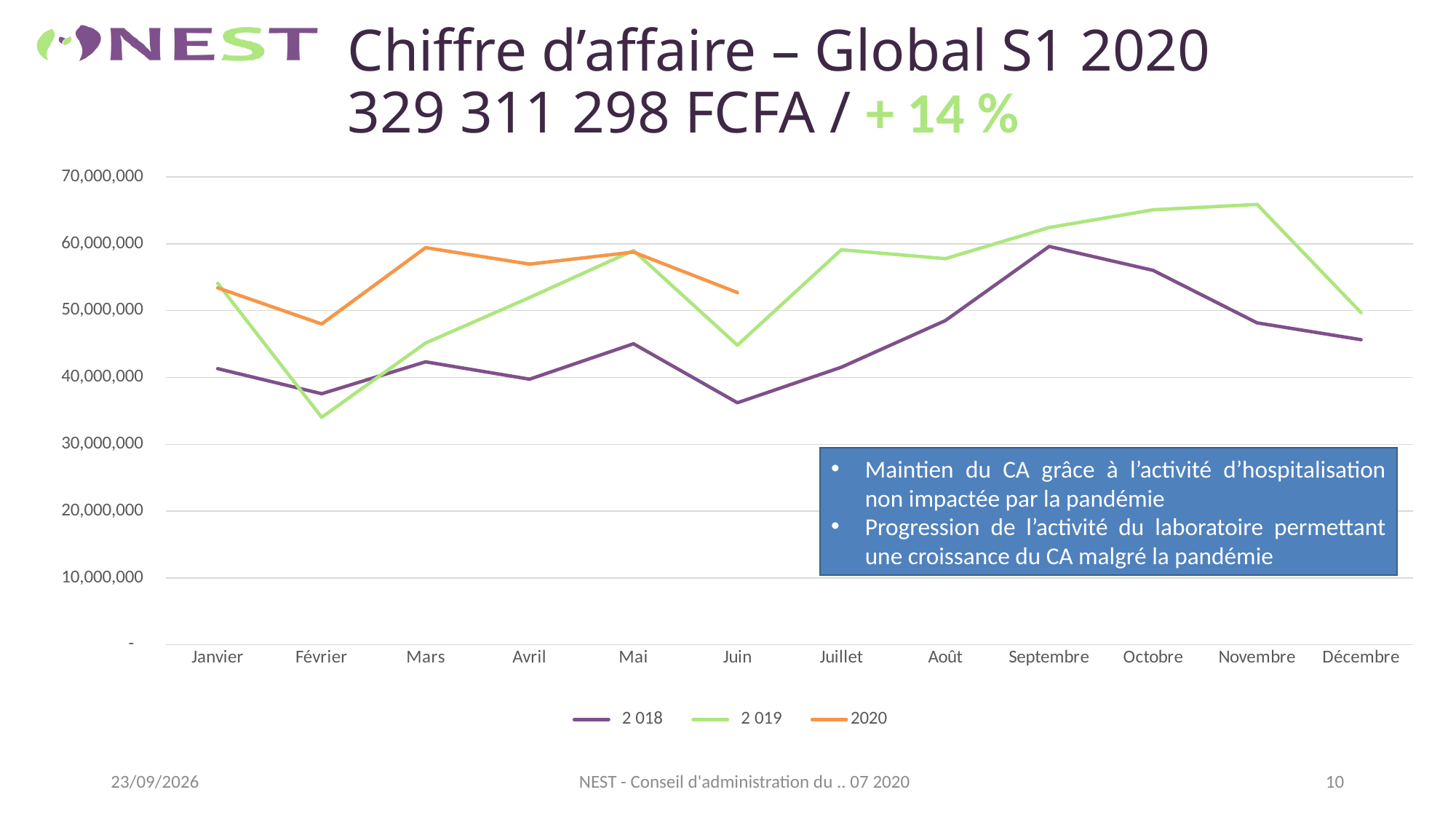
Is the value for 2 019 in Février greater or less than 40,000,000? less In which month does the 2 018 series reach its highest value? Septembre Does the 2 018 series rise or fall from Septembre to Décembre? fall In Juin, which series has the larger value, 2020 or 2 018? 2020 In which month is the 2020 series at its lowest? Février How many series does the legend list? 3 Is the value for 2 019 in Novembre greater or less than 60,000,000? greater In which month does the 2 019 series reach its highest value? Novembre In which month does the 2 019 series reach its lowest value? Février What kind of chart is shown on the slide? line chart Is the value for 2020 in Février greater or less than 50,000,000? less How many months are shown on the x axis? 12